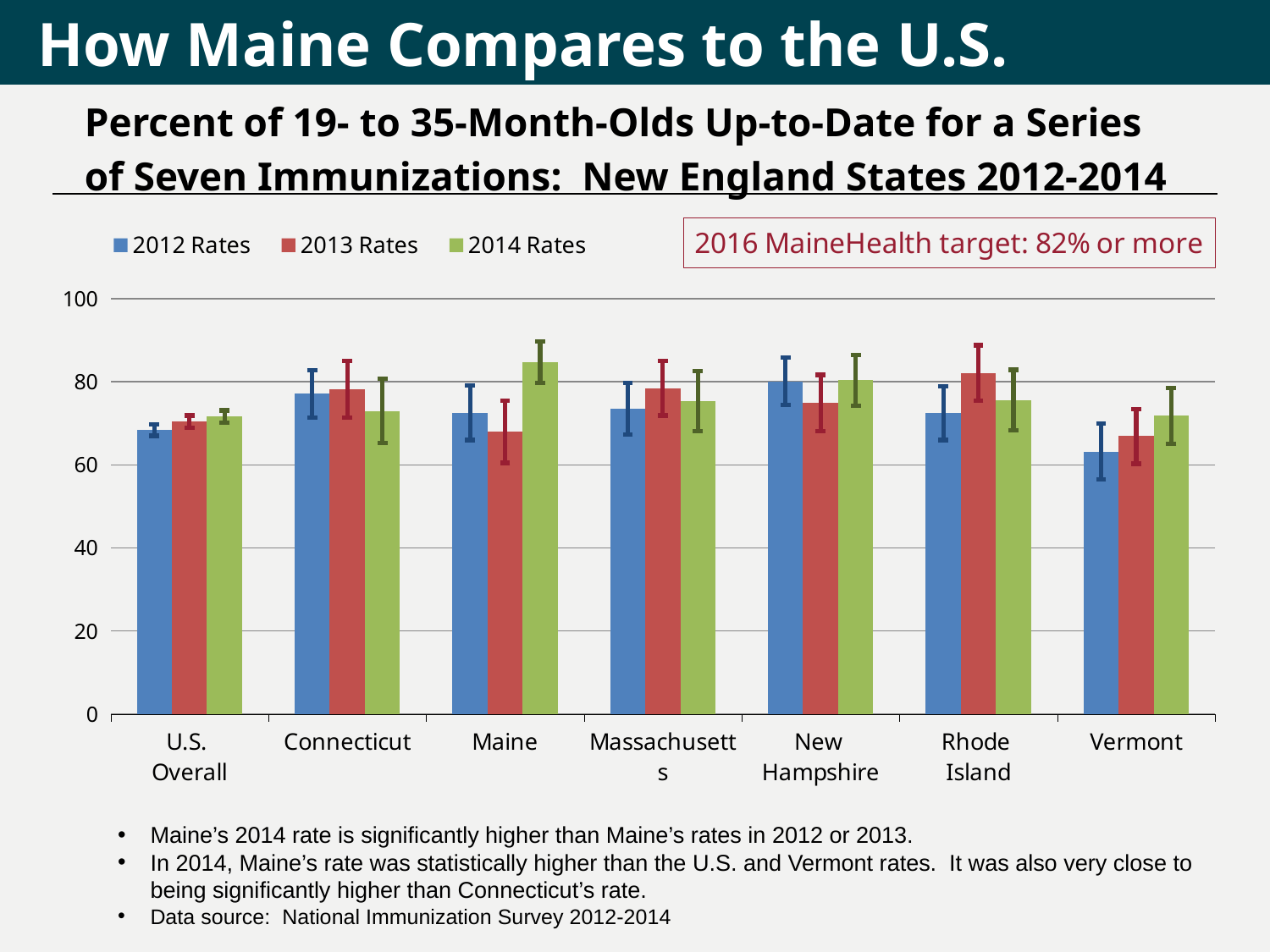
How many states/regions are shown along the x axis? 7 Which category has the highest 2014 Rates value? Maine For Maine, which is larger: the 2013 Rates value or the 2014 Rates value? 2014 Rates Is the 2014 Rates value for Connecticut greater or less than 80? less Is the 2014 Rates value for Maine greater or less than 80? greater Which category has the highest 2013 Rates value? Rhode Island How many series does the legend list? 3 Which category has the lowest 2012 Rates value? Vermont Is the 2012 Rates value for Vermont greater or less than 70? less What kind of chart is shown on the slide? Bar chart What is the 2016 MaineHealth target stated on the slide? 82% or more For Rhode Island, which is larger: the 2012 Rates value or the 2013 Rates value? 2013 Rates